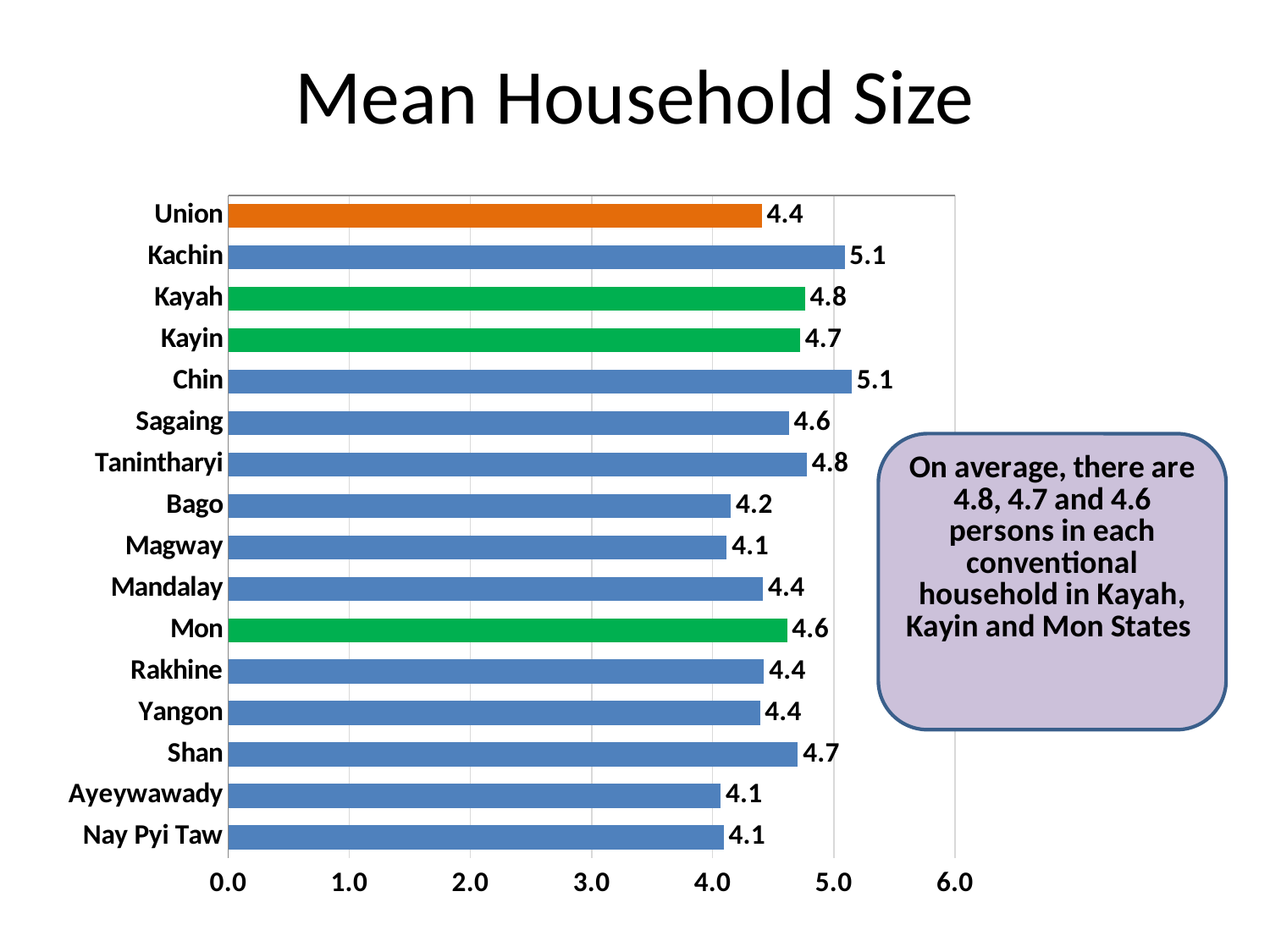
What is the mean household size for Bago? 4.2 Which has a larger mean household size, Sagaing or Ayeywawady? Sagaing What kind of chart is shown on the slide? bar chart Is the value for Kachin greater or less than 5.0? greater What is the difference between the mean household size of Kayah and Mon? 0.2 What is the mean household size for Union? 4.4 What is the mean household size for Nay Pyi Taw? 4.1 Which has a larger mean household size, Kayin or Bago? Kayin How many categories are shown on the chart? 16 What is the mean household size for Kachin? 5.1 What is the title of the chart? Mean Household Size What is the difference between the mean household size of Chin and Magway? 1.0